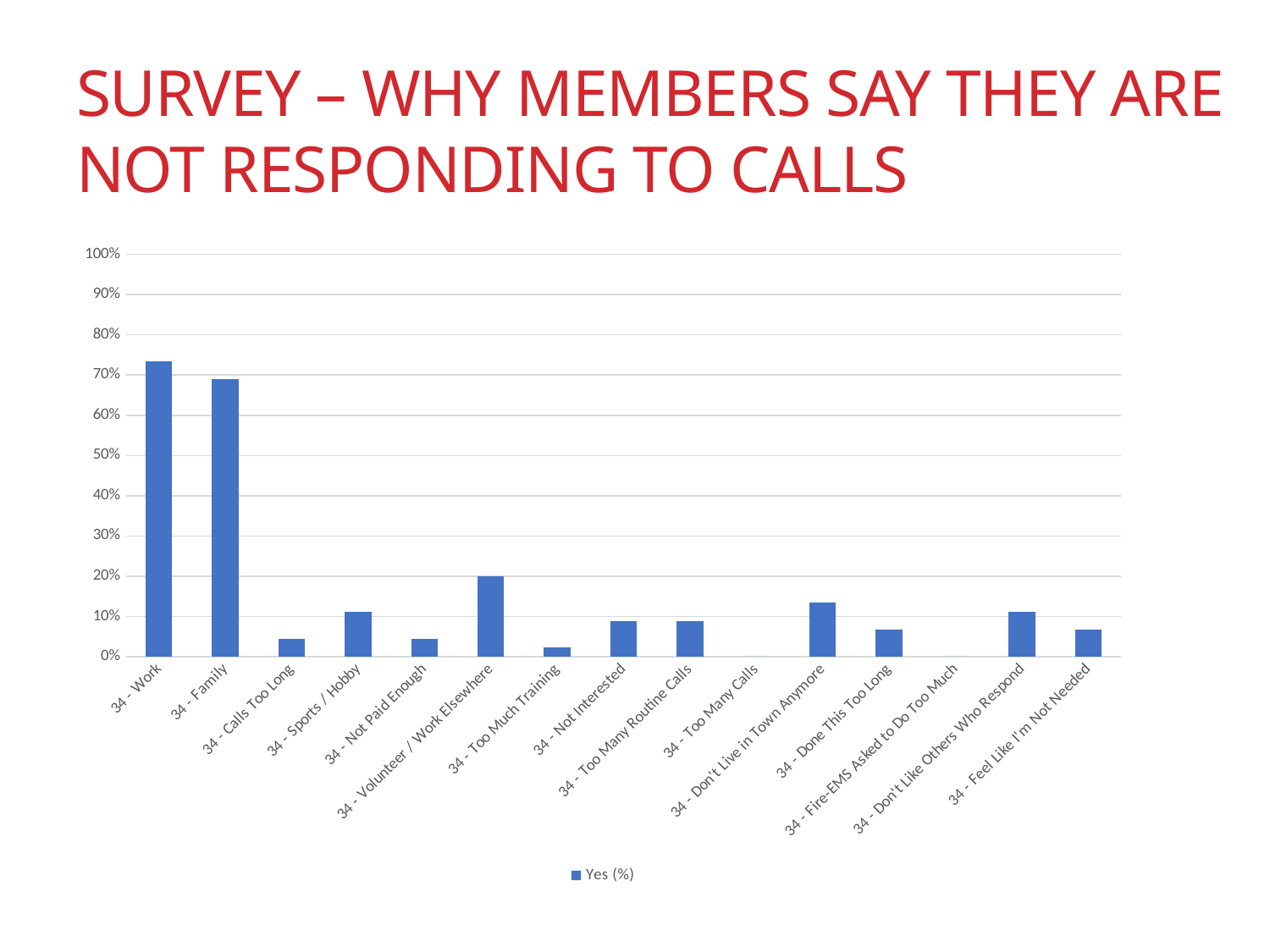
Is the value for 34 - Too Much Training greater or less than 10%? less How many series does the chart's legend list? 1 Is the value for 34 - Family greater or less than 60%? greater What kind of chart is shown on the slide? bar chart Which is larger, the value for 34 - Volunteer / Work Elsewhere or the value for 34 - Sports / Hobby? 34 - Volunteer / Work Elsewhere Is the value for 34 - Work greater or less than 60%? greater What is the name of the series shown in the chart's legend? Yes (%) How many categories are shown on the x axis of the chart? 15 Which is larger, the value for 34 - Don't Live in Town Anymore or the value for 34 - Done This Too Long? 34 - Don't Live in Town Anymore Which is larger, the value for 34 - Work or the value for 34 - Family? 34 - Work Which category has the highest value in the chart? 34 - Work